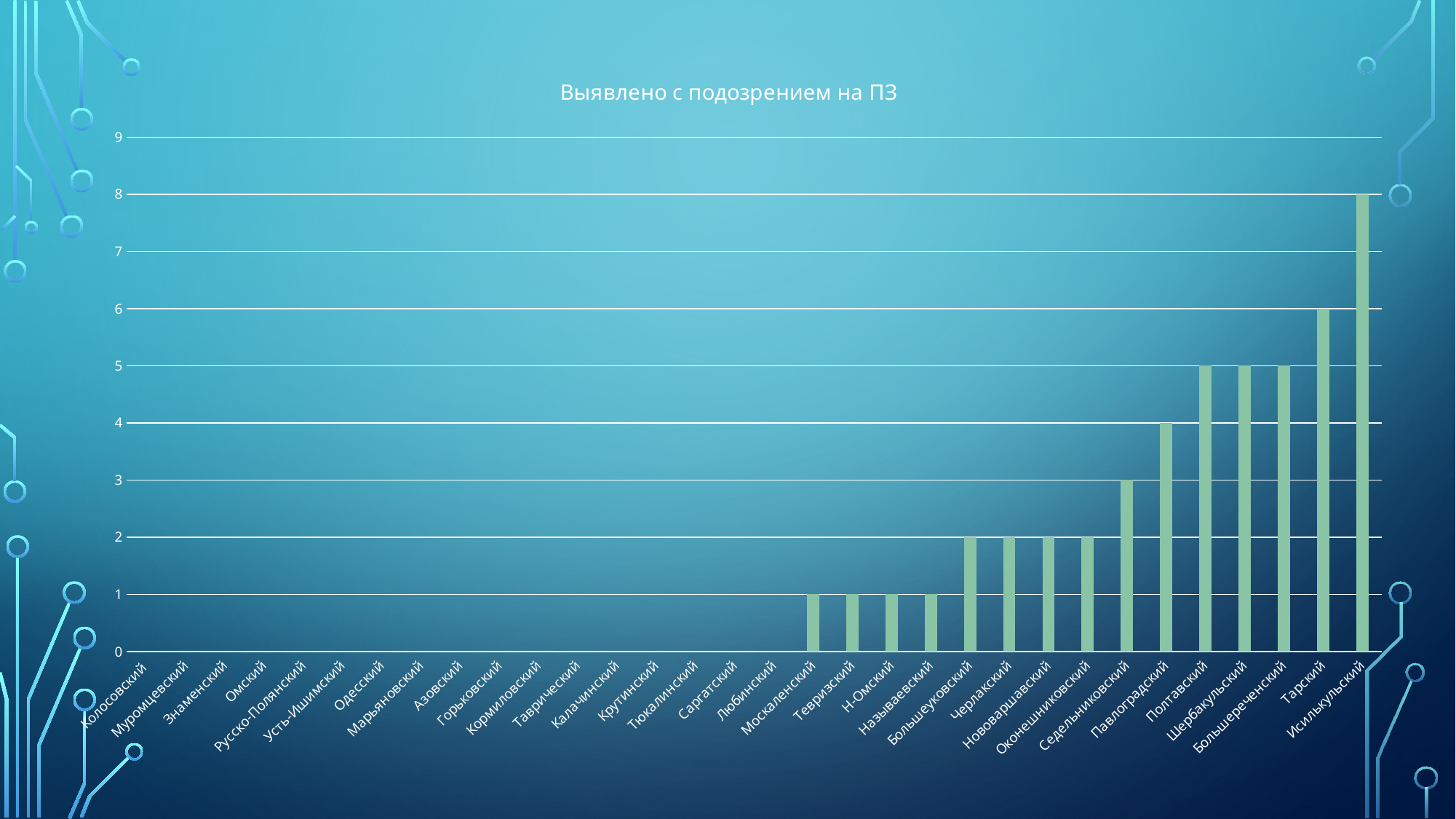
What is the title of the chart? Выявлено с подозрением на ПЗ What is the value for Седельниковский? 3 What is the value for Москаленский? 1 What kind of chart is shown on the slide? bar chart Which is larger, the value for Полтавский or the value for Павлоградский? Полтавский What is the value for Исилькульский? 8 Do the values generally rise or fall from left to right along the x axis? rise What is the value for Павлоградский? 4 What is the difference between the values for Исилькульский and Тарский? 2 What is the value for Тарский? 6 Which category has the highest value? Исилькульский How many categories are shown on the x axis? 32